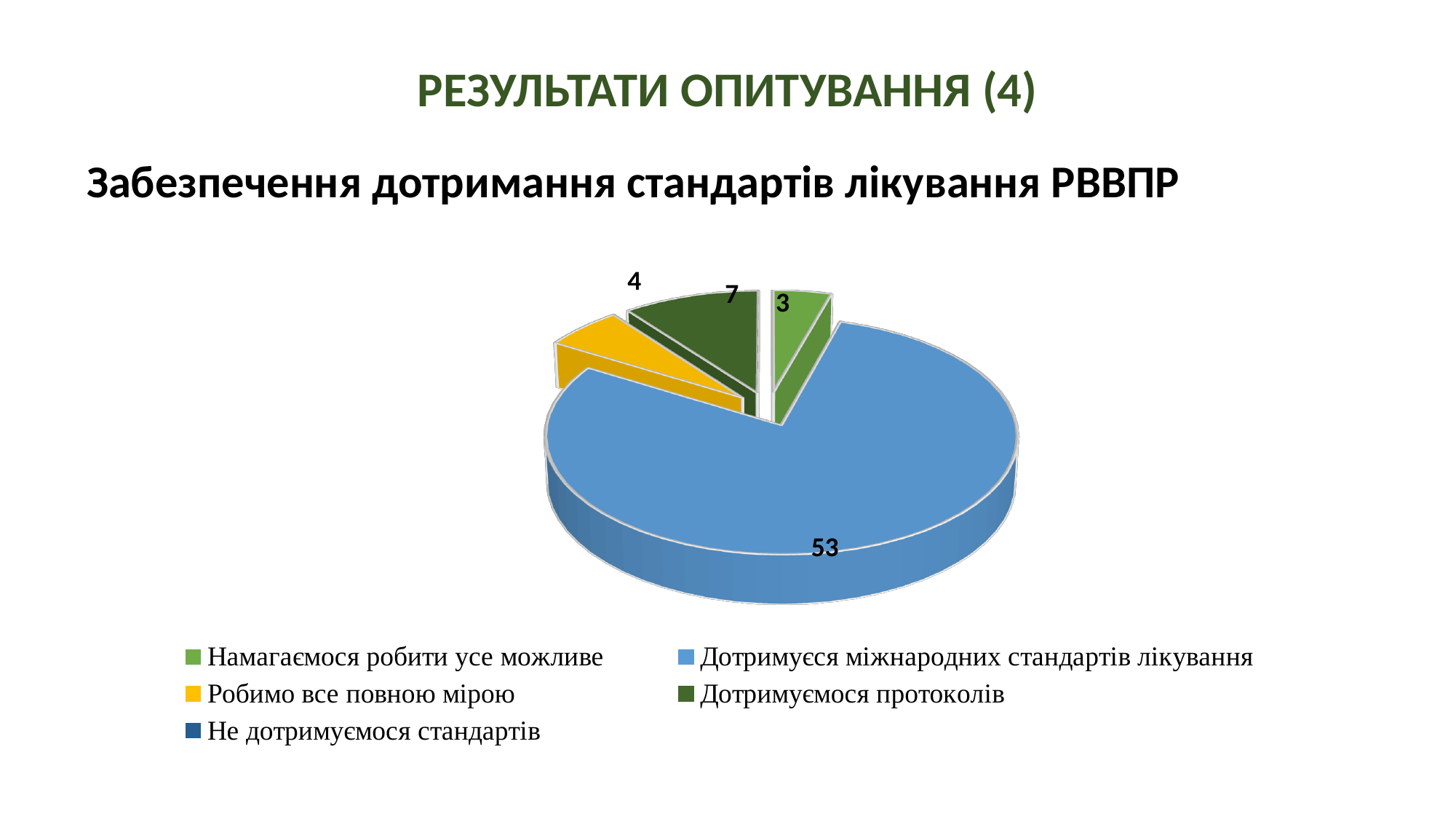
Which is larger: "Дотримуємося протоколів" or "Робимо все повною мірою"? Дотримуємося протоколів What colour is the largest slice of the pie? Blue What kind of chart is shown on the slide? Pie chart What is the difference between the values for "Дотримуюся міжнародних стандартів лікування" and "Дотримуємося протоколів"? 46 What value is shown for "Робимо все повною мірою"? 4 How many entries does the legend list? 5 What value is shown for "Намагаємося робити усе можливе"? 3 What value is shown for "Дотримуюся міжнародних стандартів лікування"? 53 What value is shown for "Дотримуємося протоколів"? 7 Which labelled slice has the smallest value? Намагаємося робити усе можливе What is the difference between the values for "Дотримуємося протоколів" and "Робимо все повною мірою"? 3 Which category has the largest slice of the pie? Дотримуєся міжнародних стандартів лікування